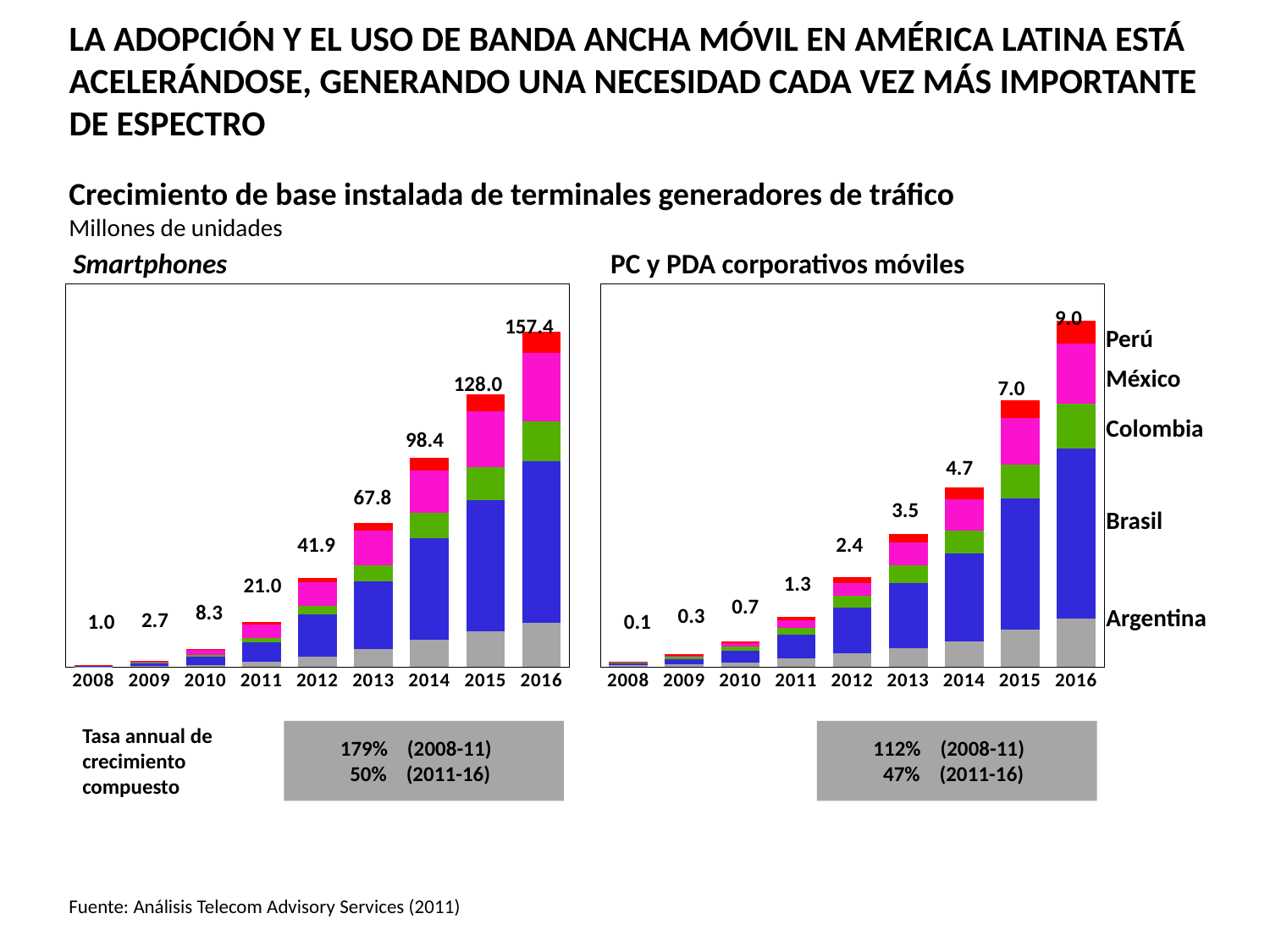
In the PC y PDA corporativos móviles chart, which year has the lowest total? 2008 In the Smartphones chart, what is the total for 2016? 157.4 What kind of chart is the PC y PDA corporativos móviles chart? stacked bar chart In the Smartphones chart, do the totals rise or fall from 2008 to 2016? rise In the PC y PDA corporativos móviles chart, what is the difference between the 2016 total and the 2015 total? 2.0 In the Smartphones chart, what is the difference between the 2016 total and the 2015 total? 29.4 In the Smartphones chart, what is the total for 2013? 67.8 In the Smartphones chart, which year has the highest total? 2016 How many years are shown on the x axis of the Smartphones chart? 9 In the Smartphones chart, is the total for 2012 larger or smaller than the total for 2013? smaller How many countries are listed in the legend shared by the two charts? 5 In the PC y PDA corporativos móviles chart, what is the total for 2015? 7.0